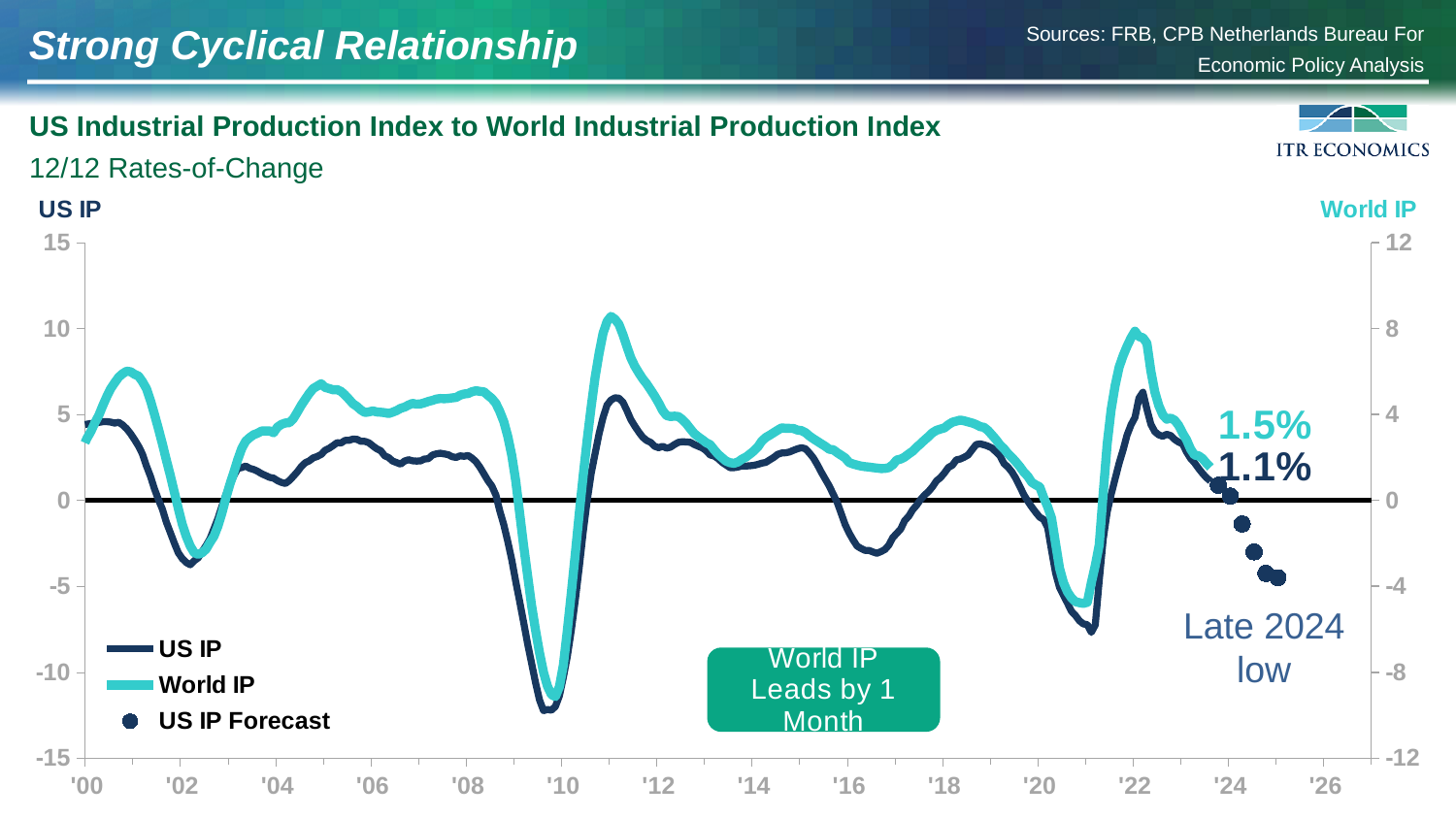
What does the annotation near the forecast points say? Late 2024 low How many year labels are shown on the x axis? 14 How many series does the legend list? 3 Which is larger, the latest labeled World IP value or the latest labeled US IP value? World IP What kind of chart is shown on the slide? line chart Is the US IP value around '16 greater or less than 0? less What is the latest labeled value for World IP? 1.5% According to the callout box, which series leads and by how much? World IP leads by 1 month What is the difference between the latest labeled World IP value (1.5%) and the latest labeled US IP value (1.1%)? 0.4% What is the latest labeled value for US IP? 1.1% Is the US IP value at its trough around '10 greater or less than -10 on the left axis? less Do the US IP Forecast points rise or fall from '24 to '25? fall